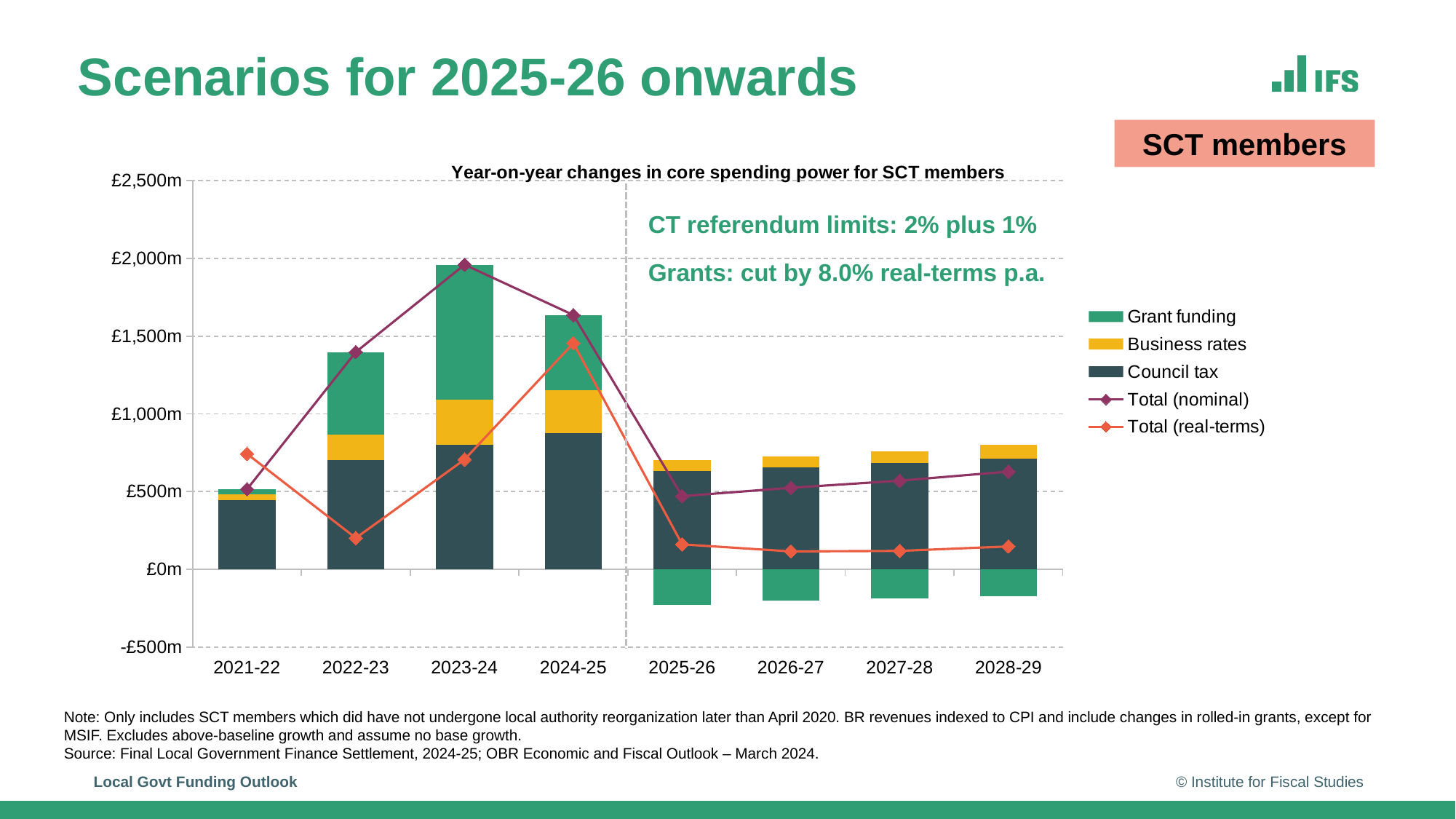
What kind of chart is shown on the slide? A stacked bar chart with line series What is the title of the chart? Year-on-year changes in core spending power for SCT members Is the Grant funding value for 2025-26 greater or less than £0m? less Which series is shown in yellow in the chart legend? Business rates Is the Council tax value for 2024-25 greater or less than £500m? greater Is the Total (nominal) value for 2023-24 greater or less than £1,500m? greater Which is larger, the Total (nominal) value for 2023-24 or for 2024-25? 2023-24 How many series does the chart legend list? 5 How many years are shown on the x axis of the chart? 8 In which year is the Total (nominal) line at its highest? 2023-24 Does the Total (nominal) line rise or fall from 2025-26 to 2028-29? Rise